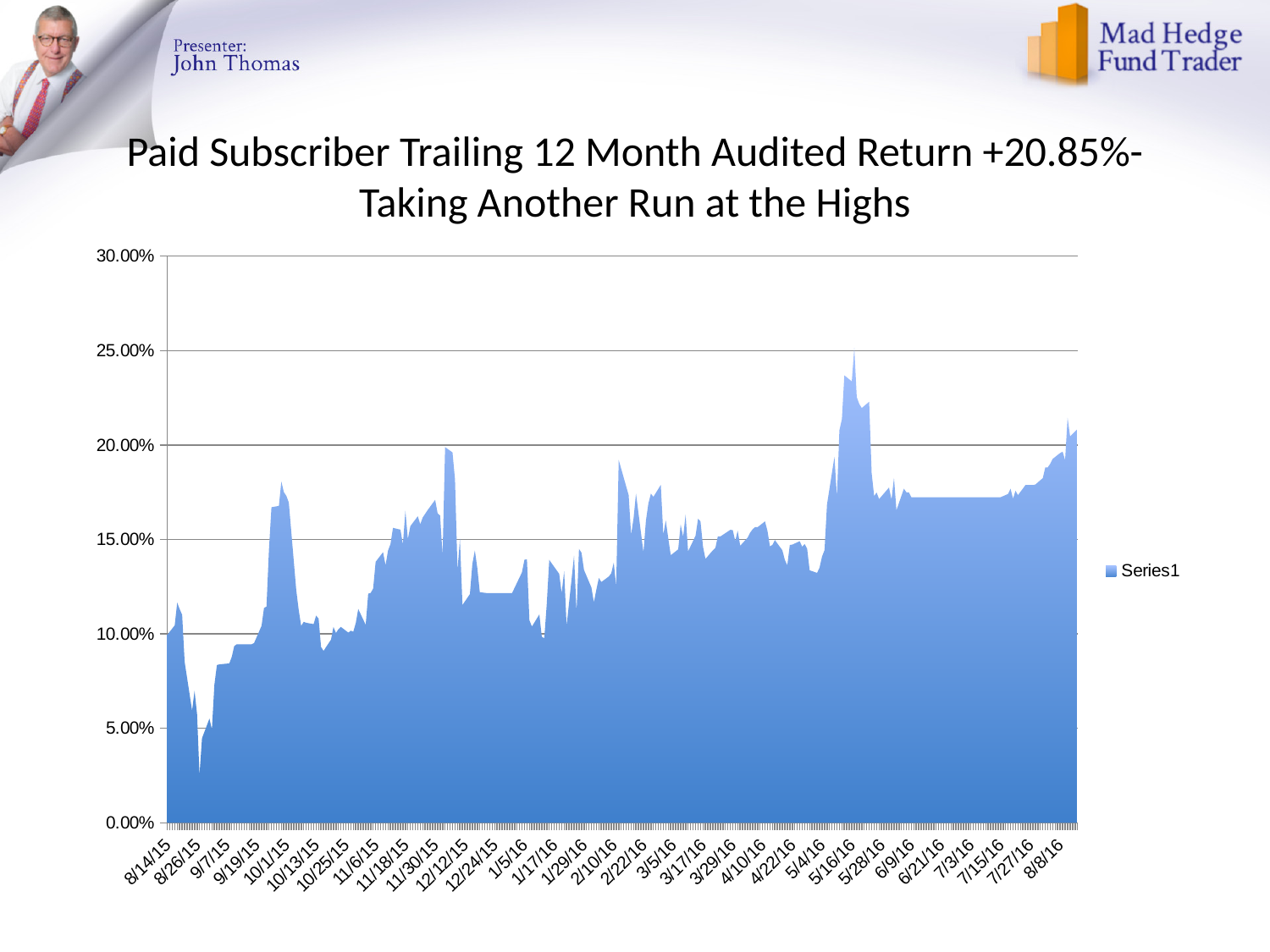
What trailing 12 month audited return is stated in the chart title? +20.85% What kind of chart is shown on the slide? Area chart How many series does the legend list? 1 Is the value around 10/25/15 greater or less than 15.00%? less Is the value around 1/5/16 greater or less than 15.00%? less Around which x-axis date does the series reach its highest value? 5/16/16 Around which x-axis date does the series reach its lowest value? 8/26/15 Is the value around 5/16/16 greater or less than 20.00%? greater Comparing the start of the chart (8/14/15) with the end (8/8/16), does the value rise or fall overall? rise What is the name of the series shown in the legend? Series1